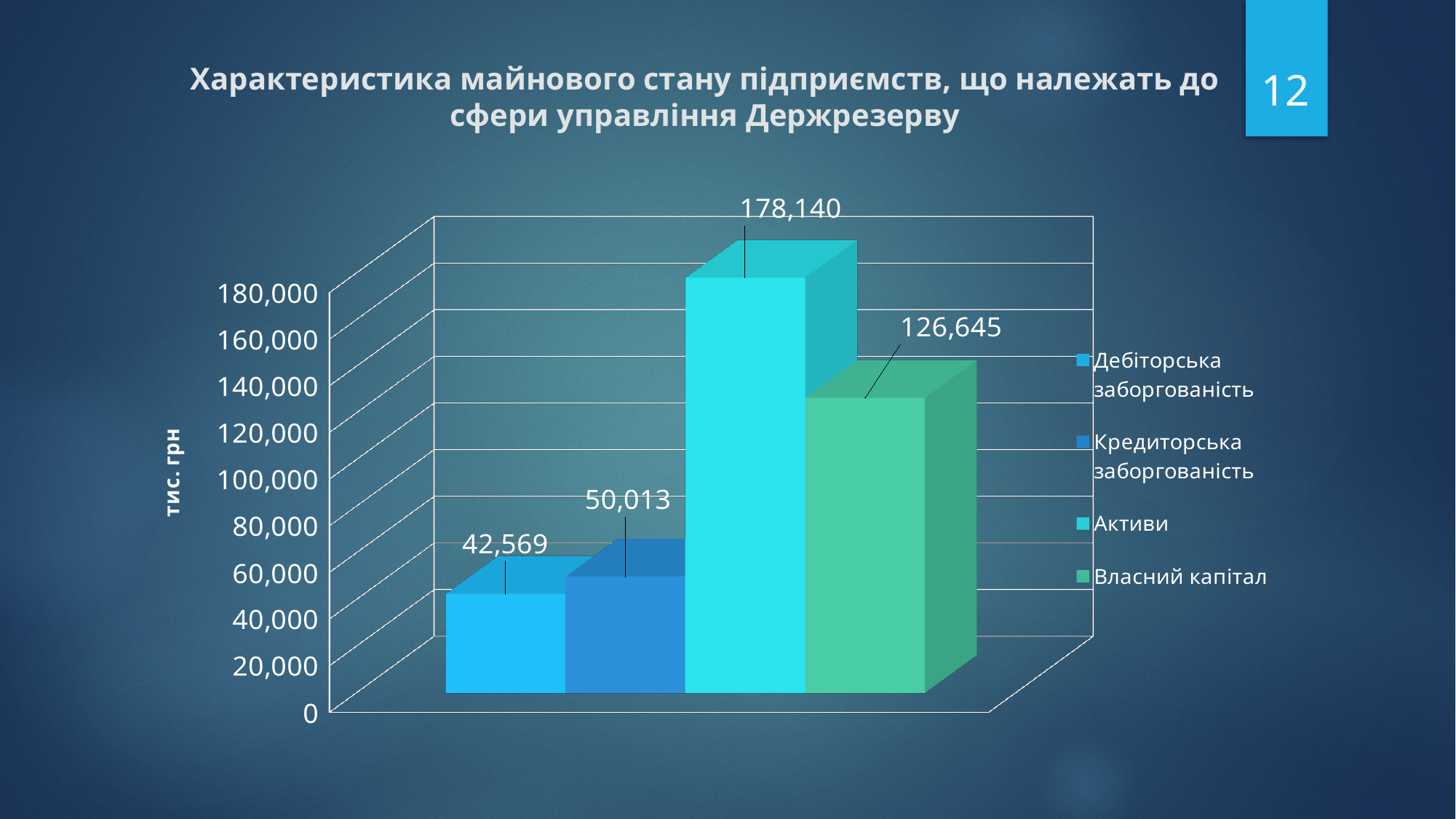
What is the value for Активи? 178,140 Which series has the highest value? Активи What is the value for Кредиторська заборгованість? 50,013 What is the value for Дебіторська заборгованість? 42,569 What is the difference between Активи and Власний капітал? 51,495 What is the difference between Кредиторська заборгованість and Дебіторська заборгованість? 7,444 What kind of chart is shown on the slide? Bar chart Which is larger, Кредиторська заборгованість or Дебіторська заборгованість? Кредиторська заборгованість Which series has the lowest value? Дебіторська заборгованість How many series does the legend list? 4 What is the label of the vertical axis? тис. грн What is the value for Власний капітал? 126,645